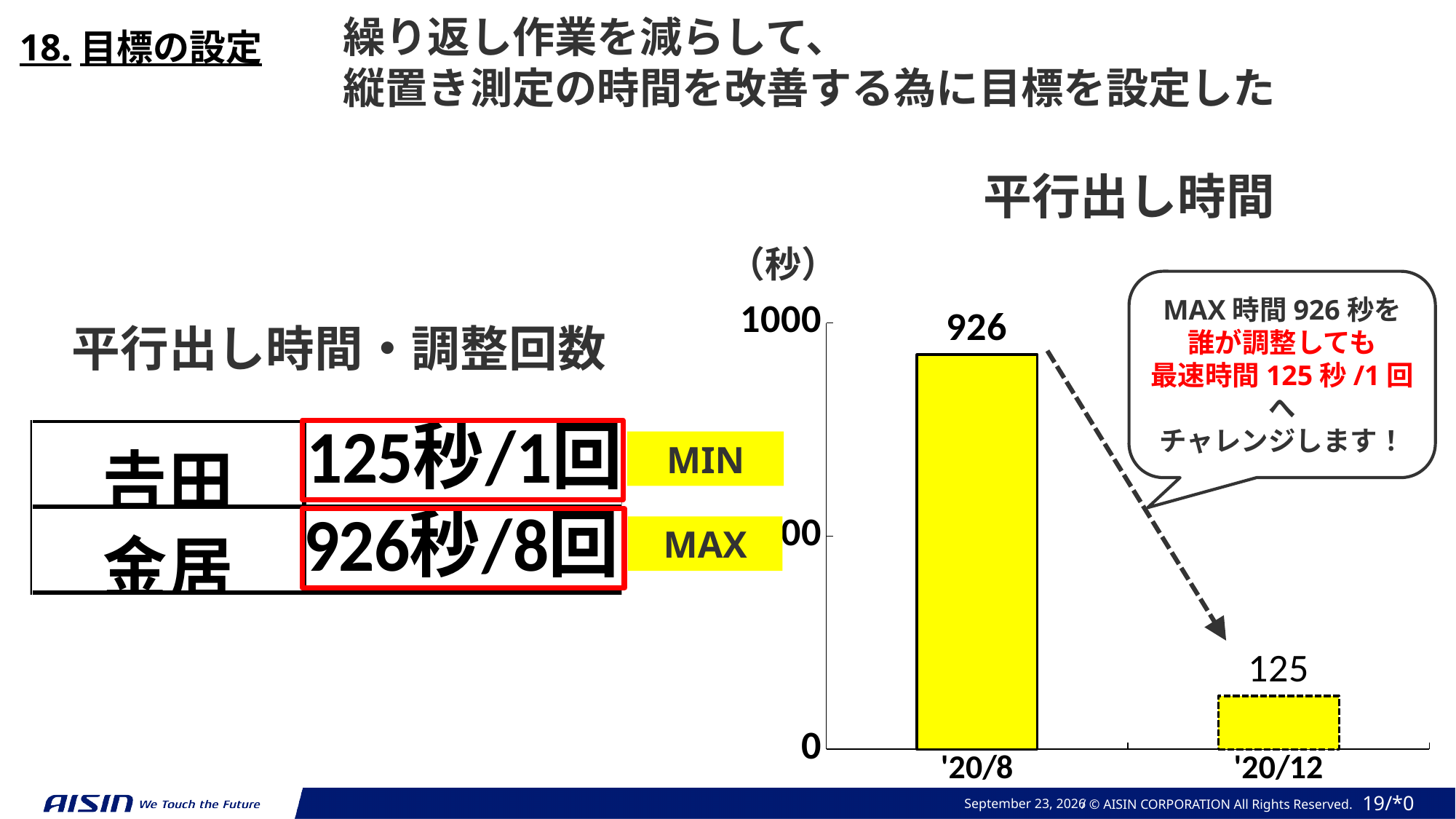
What is the title of the chart on the slide? 平行出し時間 What is the value for '20/12 in the 平行出し時間 chart? 125 Do the values in the 平行出し時間 chart rise or fall from '20/8 to '20/12? fall What is the difference between the '20/8 and '20/12 values in the 平行出し時間 chart? 801 Is the value for '20/12 in the 平行出し時間 chart greater or less than 1000? less Which category has the lowest value in the 平行出し時間 chart? '20/12 What is the value for '20/8 in the 平行出し時間 chart? 926 In the 平行出し時間 chart, which is larger, the value for '20/8 or the value for '20/12? '20/8 How many bars are plotted in the 平行出し時間 chart? 2 Which category has the highest value in the 平行出し時間 chart? '20/8 What unit is shown on the y axis of the 平行出し時間 chart? 秒 What kind of chart is the 平行出し時間 chart? bar chart